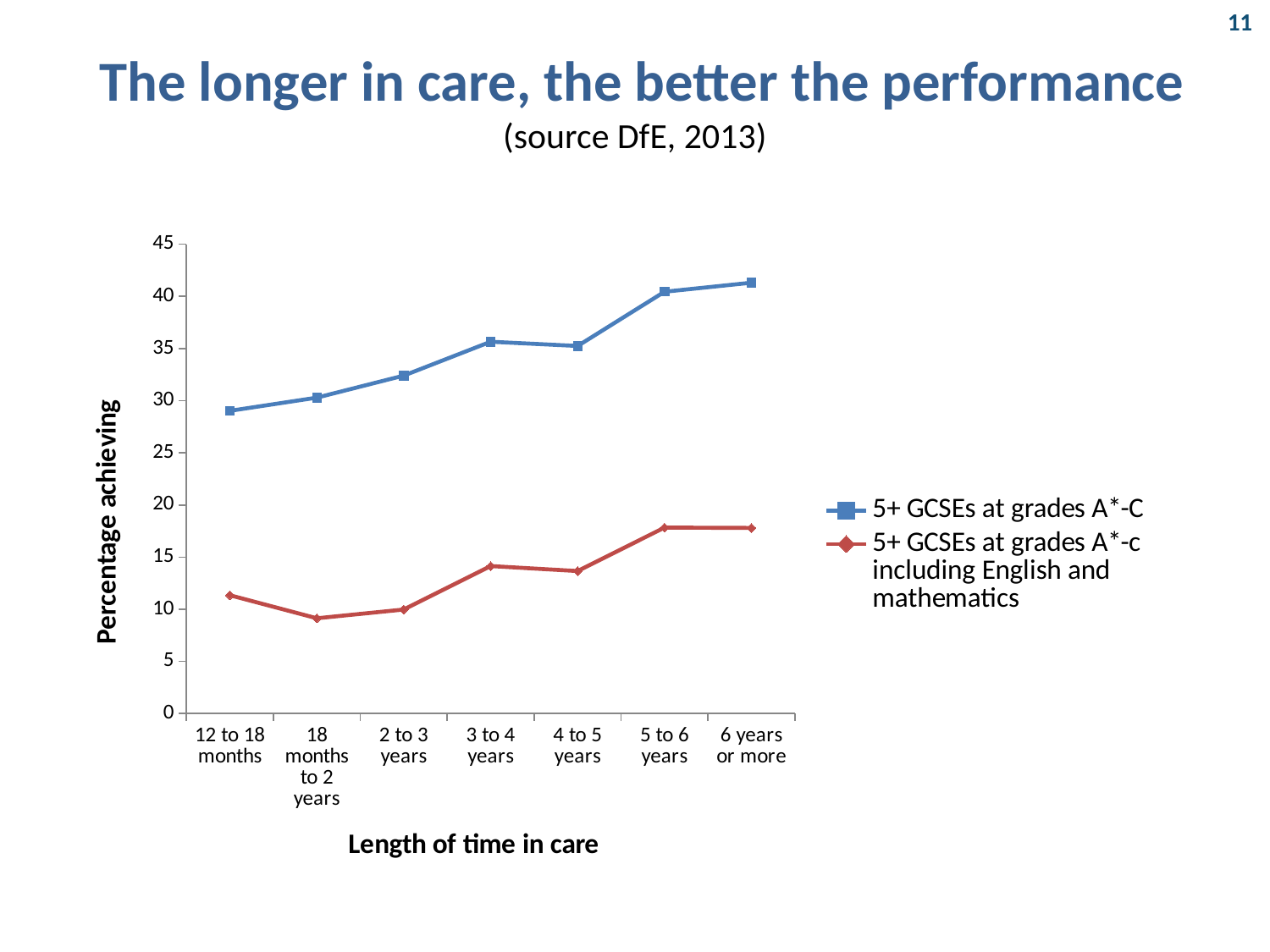
Is the value for '5+ GCSEs at grades A*-C' at '3 to 4 years' greater or less than 30? greater Is the value for '5+ GCSEs at grades A*-c including English and mathematics' at '18 months to 2 years' greater or less than 15? less Is the value for '5+ GCSEs at grades A*-c including English and mathematics' at '5 to 6 years' greater or less than 15? greater Overall, do the values for '5+ GCSEs at grades A*-C' rise or fall as length of time in care increases? rise At '4 to 5 years', which series has the higher value: '5+ GCSEs at grades A*-C' or '5+ GCSEs at grades A*-c including English and mathematics'? 5+ GCSEs at grades A*-C For '5+ GCSEs at grades A*-c including English and mathematics', is the value higher at '18 months to 2 years' or at '3 to 4 years'? 3 to 4 years How many series does the legend list? 2 How many length-of-time-in-care categories are plotted on the x axis? 7 What kind of chart is shown on the slide? line chart What is the title of the vertical axis? Percentage achieving